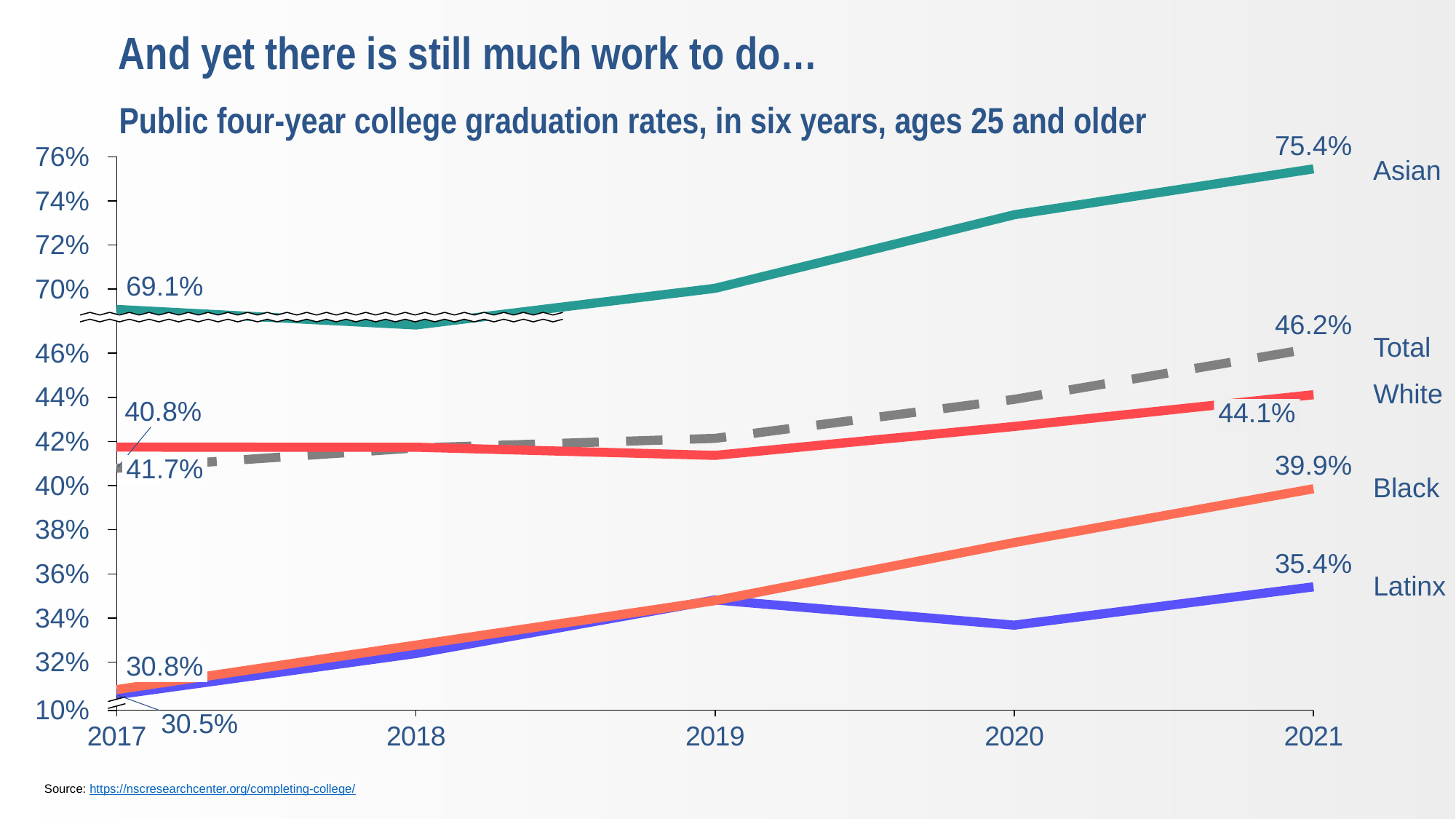
What is the Latinx graduation rate in 2021? 35.4% What is the White graduation rate in 2021? 44.1% Is the Asian graduation rate in 2020 greater or less than 72%? greater What is the Asian graduation rate in 2021? 75.4% How many years are shown on the x axis? 5 What is the Total graduation rate in 2021? 46.2% What is the Black graduation rate in 2021? 39.9% By how many percentage points did the Asian graduation rate rise from 2017 to 2021? 6.3 percentage points Which group has the lowest graduation rate in 2021? Latinx What is the Asian graduation rate in 2017? 69.1% Which group has the highest graduation rate in 2021? Asian What kind of chart is shown on the slide? Line chart